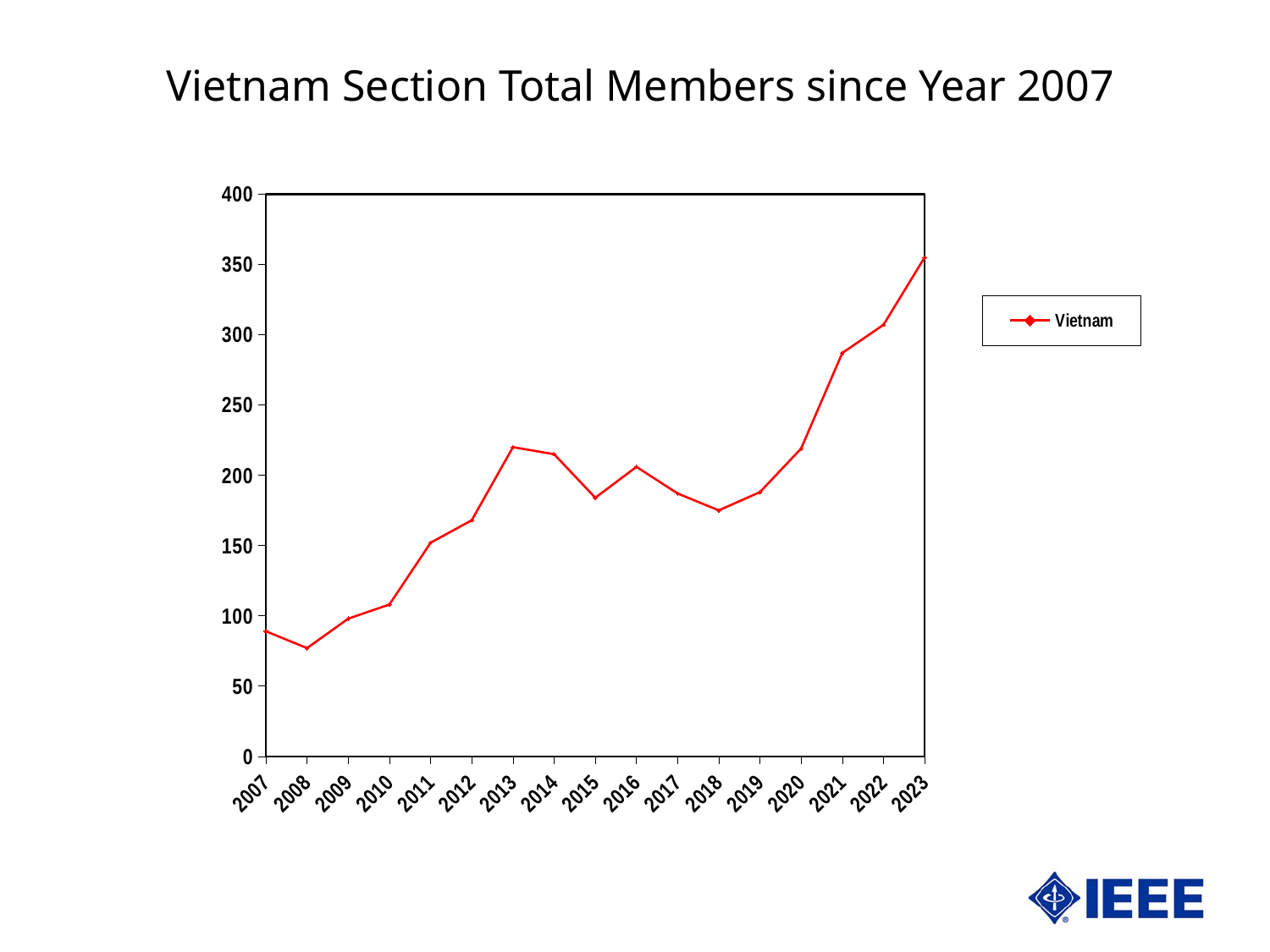
Which year has more members, 2013 or 2016? 2013 Is the value for 2018 greater or less than 200? less Is the value for 2023 greater or less than 300? greater Overall, do the values rise or fall from 2007 to 2023? rise How many series does the legend list? 1 In which year is the number of members highest? 2023 What is the name of the series shown in the legend? Vietnam What is the title of the chart? Vietnam Section Total Members since Year 2007 How many years are plotted on the x axis? 17 Is the value for 2008 greater or less than 100? less In which year is the number of members lowest? 2008 What kind of chart is shown on the slide? line chart